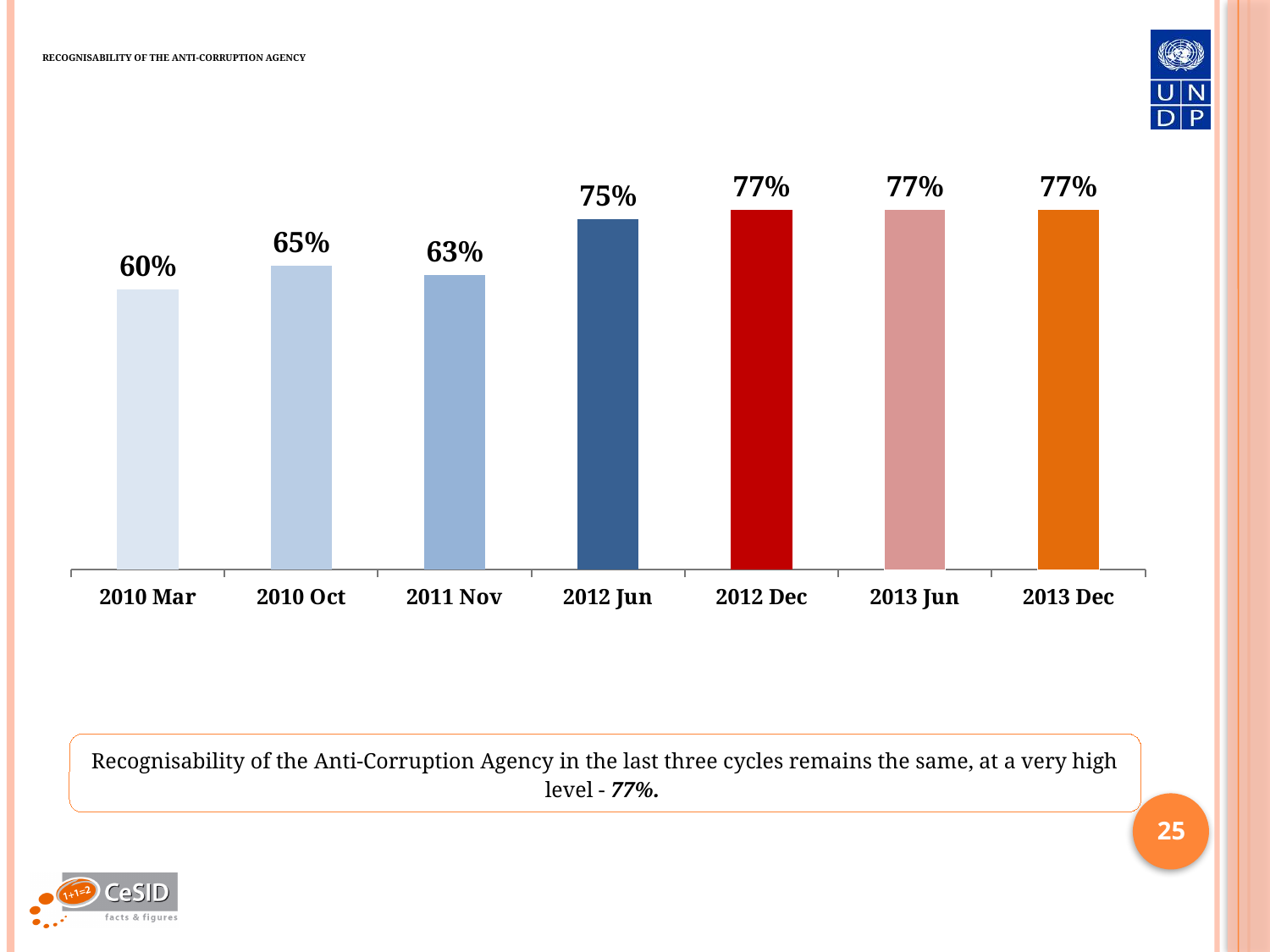
What is the value for 2013 Dec? 77% How many categories are shown on the x axis? 7 What is the value for 2010 Mar? 60% What is the value for 2012 Jun? 75% Which category has the lowest value? 2010 Mar What is the value for 2011 Nov? 63% Do the values generally rise or fall from 2010 Mar to 2013 Dec? rise What kind of chart is shown on the slide? bar chart What is the difference between the values for 2010 Oct and 2011 Nov? 2% How many categories share the highest value of 77%? 3 Which is larger, the value for 2010 Oct or the value for 2011 Nov? 2010 Oct What is the difference between the values for 2012 Jun and 2010 Mar? 15%